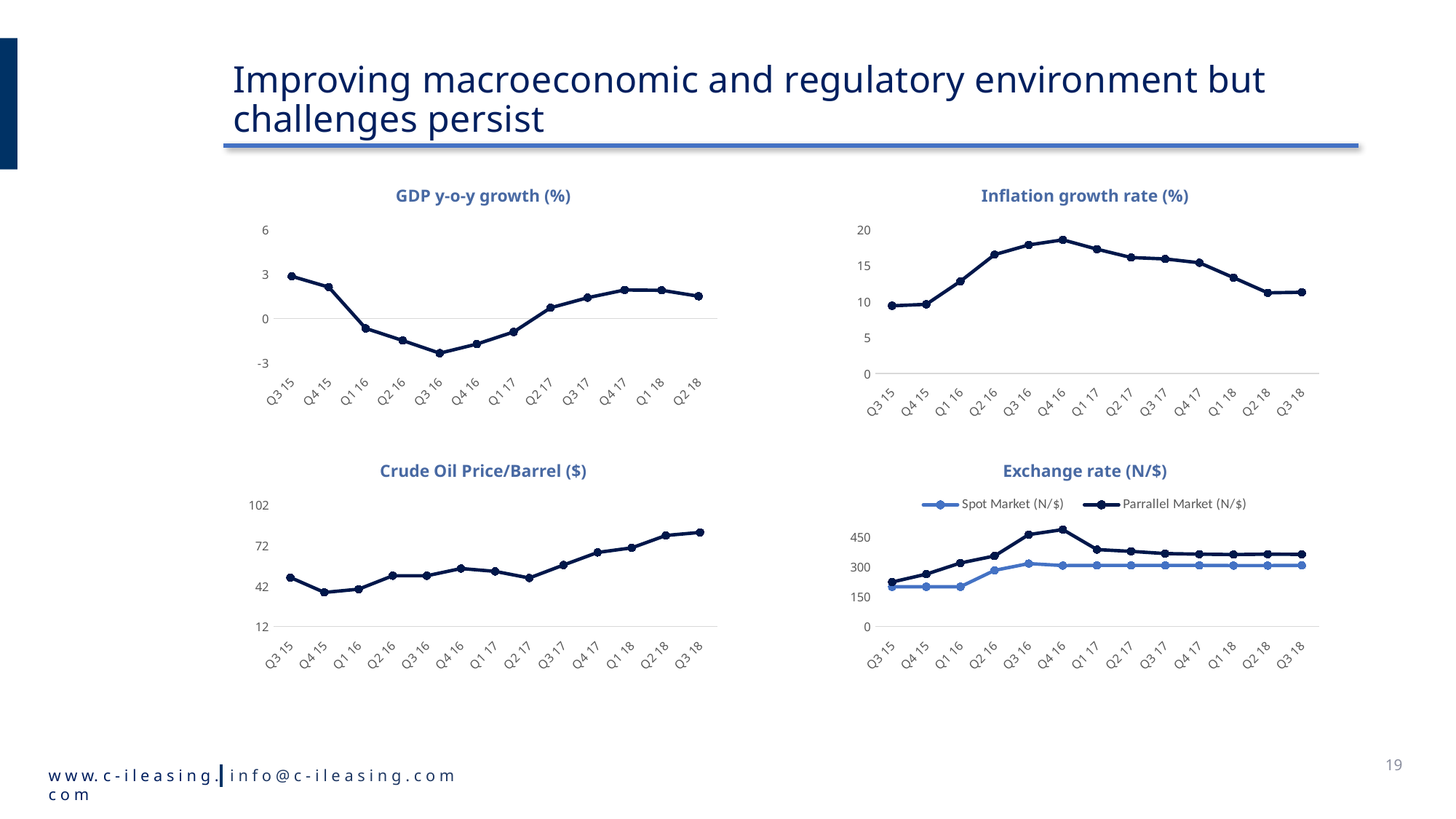
What kind of chart is the GDP y-o-y growth (%) chart? line chart In the Inflation growth rate (%) chart, which quarter has the highest value? Q4 16 In the Inflation growth rate (%) chart, is the value for Q4 16 greater or less than 15? greater In the Crude Oil Price/Barrel ($) chart, is the value for Q3 18 greater or less than 72? greater In the Crude Oil Price/Barrel ($) chart, which quarter has the lowest value? Q4 15 In the Exchange rate (N/$) chart, which is larger at Q4 16: Spot Market or Parrallel Market? Parrallel Market How many series does the legend of the Exchange rate (N/$) chart list? 2 In the Crude Oil Price/Barrel ($) chart, do values generally rise or fall from Q2 17 to Q3 18? rise How many quarters are plotted in the Inflation growth rate (%) chart? 13 In the GDP y-o-y growth (%) chart, is the value for Q3 16 greater or less than 0? less How many quarters are plotted in the GDP y-o-y growth (%) chart? 12 In the GDP y-o-y growth (%) chart, which quarter has the lowest value? Q3 16